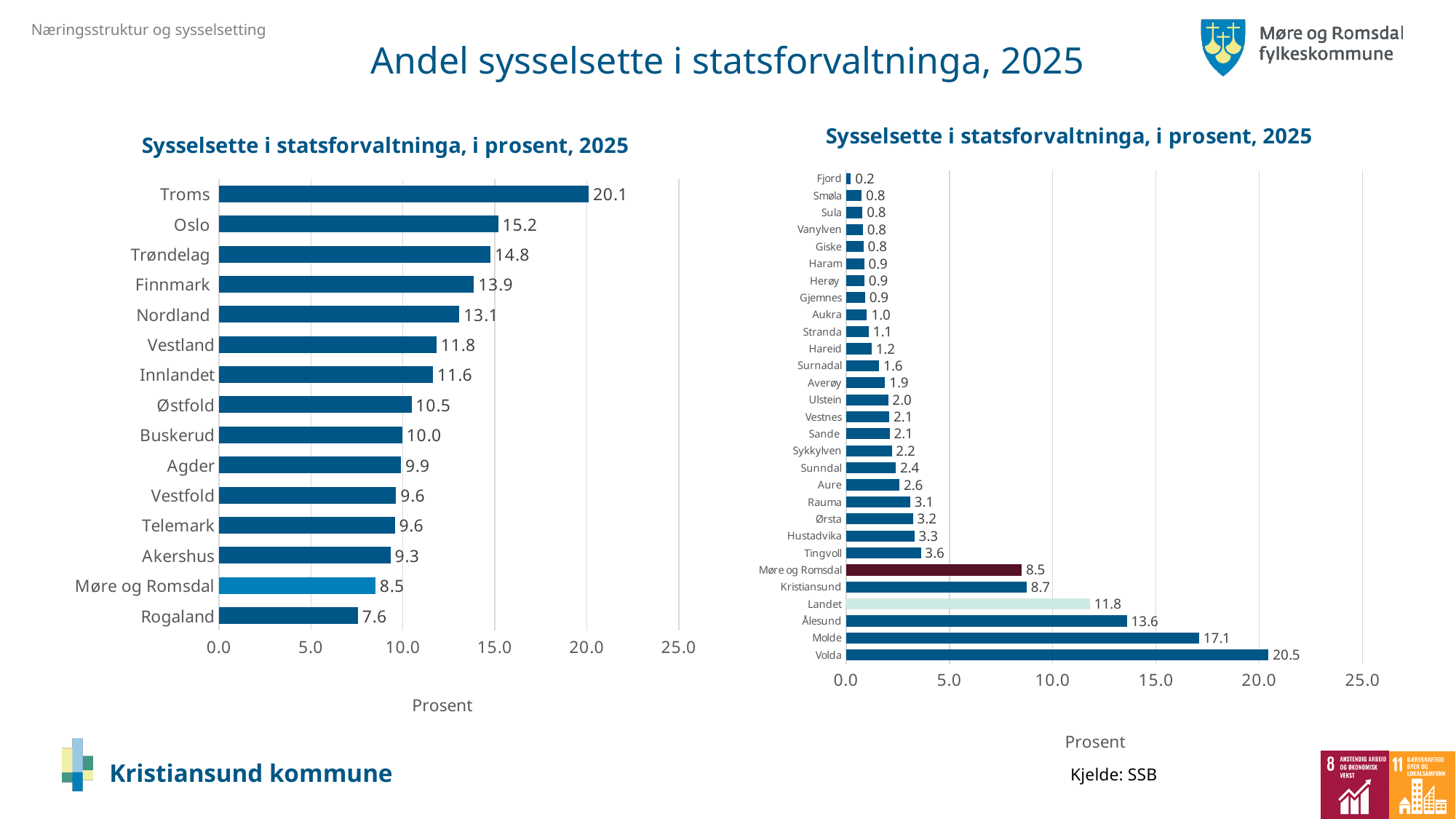
What kind of chart is the right chart? Bar chart In the left chart, what is the value for Troms? 20.1 In the left chart, what is the value for Møre og Romsdal? 8.5 In the right chart, which is larger, Molde or Ålesund? Molde In the right chart, what is the value for Kristiansund? 8.7 In the left chart, what is the difference between Oslo and Trøndelag? 0.4 In the left chart, how many categories are shown? 15 In the right chart, which category has the lowest value? Fjord In the right chart, which category has the highest value? Volda In the right chart, what is the difference between Volda and Landet? 8.7 What is the x-axis label of the left chart? Prosent In the left chart, which category has the lowest value? Rogaland